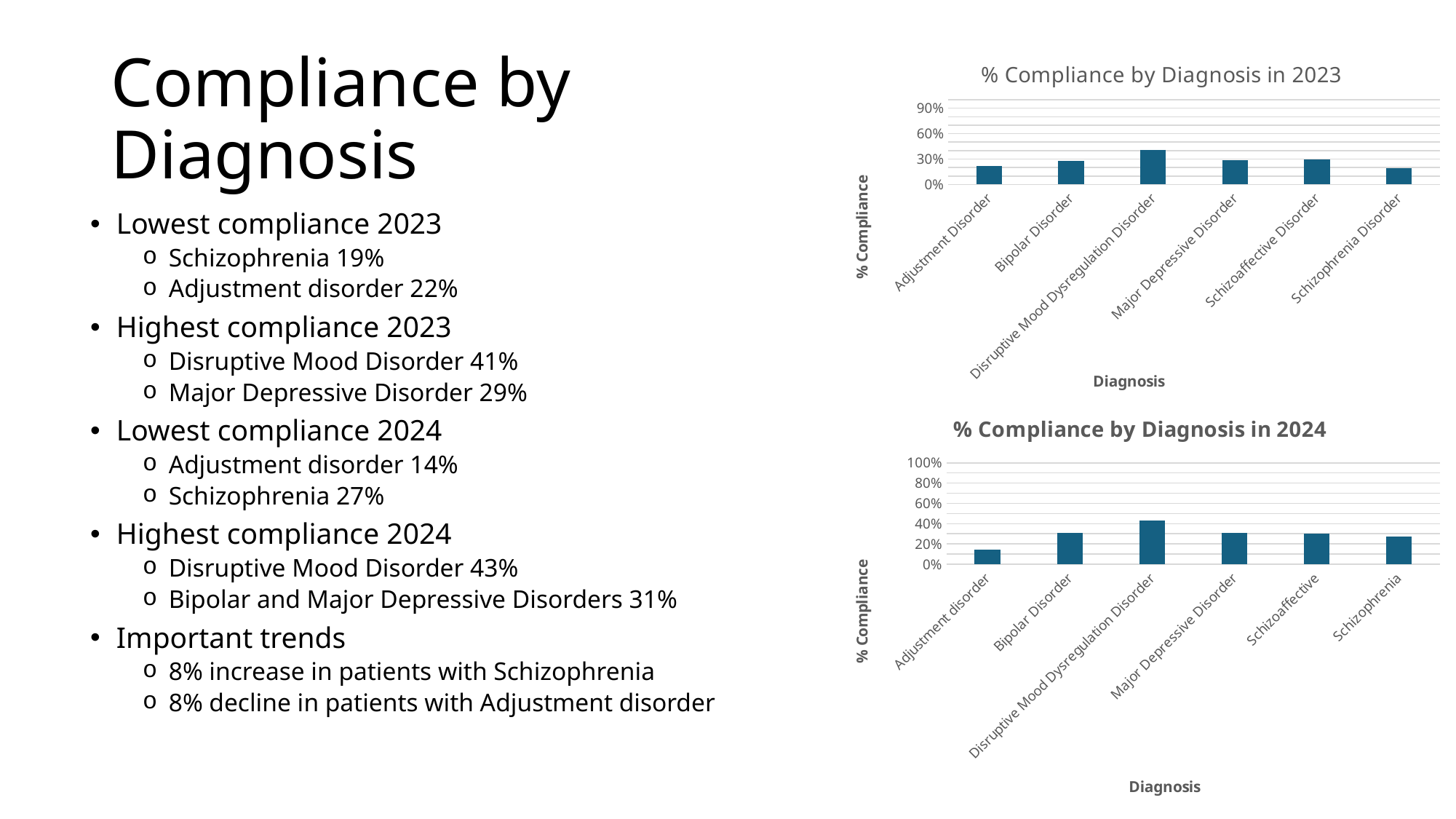
In the '% Compliance by Diagnosis in 2024' chart, is the value for Bipolar Disorder greater or less than 40%? less In the '% Compliance by Diagnosis in 2023' chart, which diagnosis has the highest compliance? Disruptive Mood Dysregulation Disorder What is the label on the vertical axis of the '% Compliance by Diagnosis in 2023' chart? % Compliance What kind of chart is the '% Compliance by Diagnosis in 2023' chart? bar chart In the '% Compliance by Diagnosis in 2024' chart, is the value for Adjustment disorder greater or less than 20%? less In the '% Compliance by Diagnosis in 2023' chart, is the value for Schizophrenia Disorder greater or less than 30%? less In the '% Compliance by Diagnosis in 2023' chart, which is larger: Bipolar Disorder or Disruptive Mood Dysregulation Disorder? Disruptive Mood Dysregulation Disorder In the '% Compliance by Diagnosis in 2024' chart, which diagnosis has the lowest compliance? Adjustment disorder In the '% Compliance by Diagnosis in 2024' chart, which diagnosis has the highest compliance? Disruptive Mood Dysregulation Disorder How many diagnosis categories are shown in the '% Compliance by Diagnosis in 2024' chart? 6 In the '% Compliance by Diagnosis in 2024' chart, which is larger: Adjustment disorder or Schizophrenia? Schizophrenia